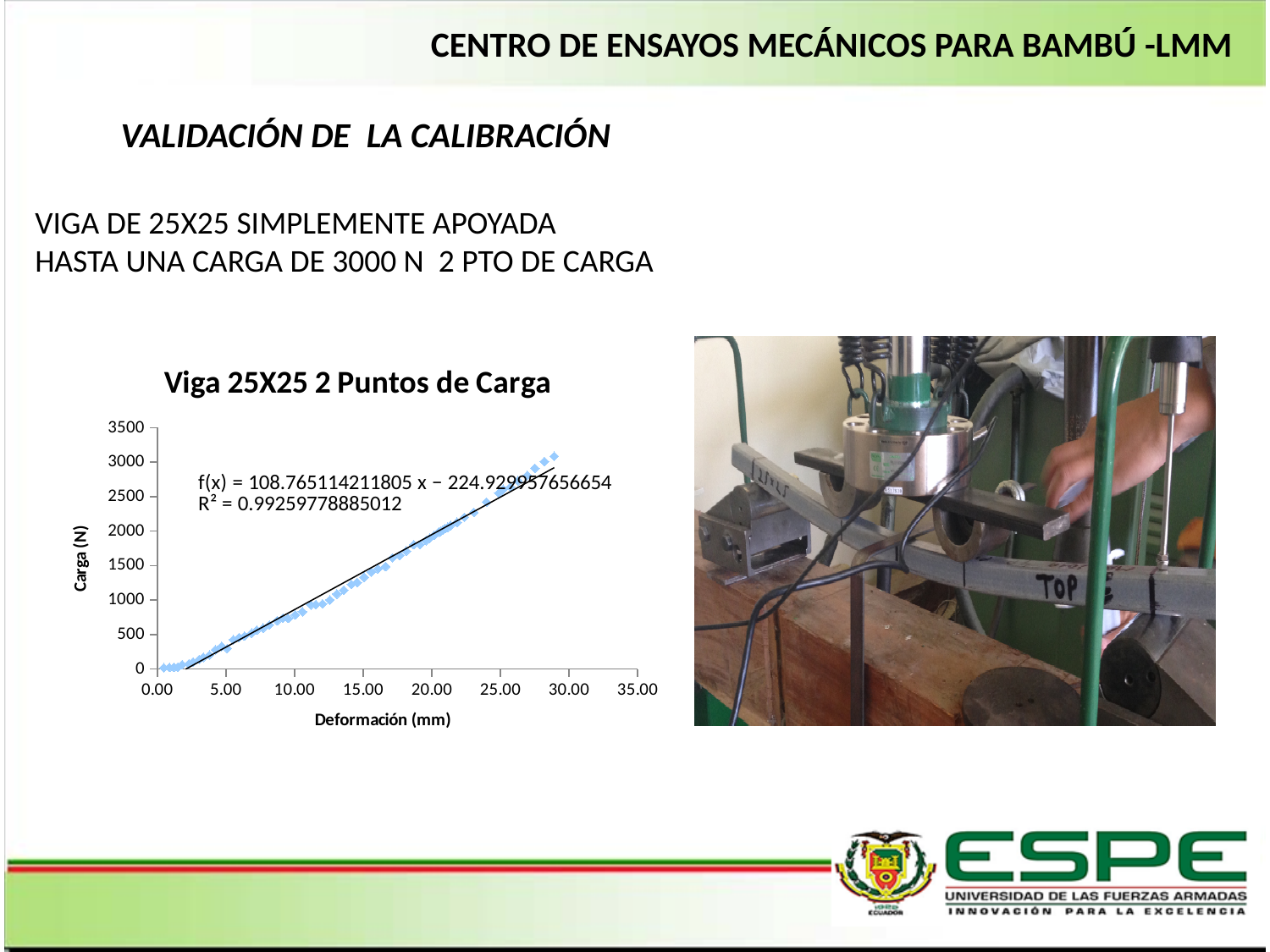
What is the R² value shown on the chart? 0.99259778885012 What is the slope of the trendline shown on the chart? 108.765114211805 What is the title of the chart on the slide? Viga 25X25 2 Puntos de Carga What is the label of the y-axis of the chart? Carga (N) Do the load values rise or fall as deformation increases along the x axis? rise Is the highest load value plotted on the chart greater or less than 2500? greater What is the highest tick value shown on the y-axis of the chart? 3500 What is the highest tick value shown on the x-axis of the chart? 35.00 Is the largest deformation value plotted on the chart greater or less than 25.00? greater What is the trendline equation shown on the chart? f(x) = 108.765114211805 x − 224.929957656654 What kind of chart is shown on the slide? scatter chart